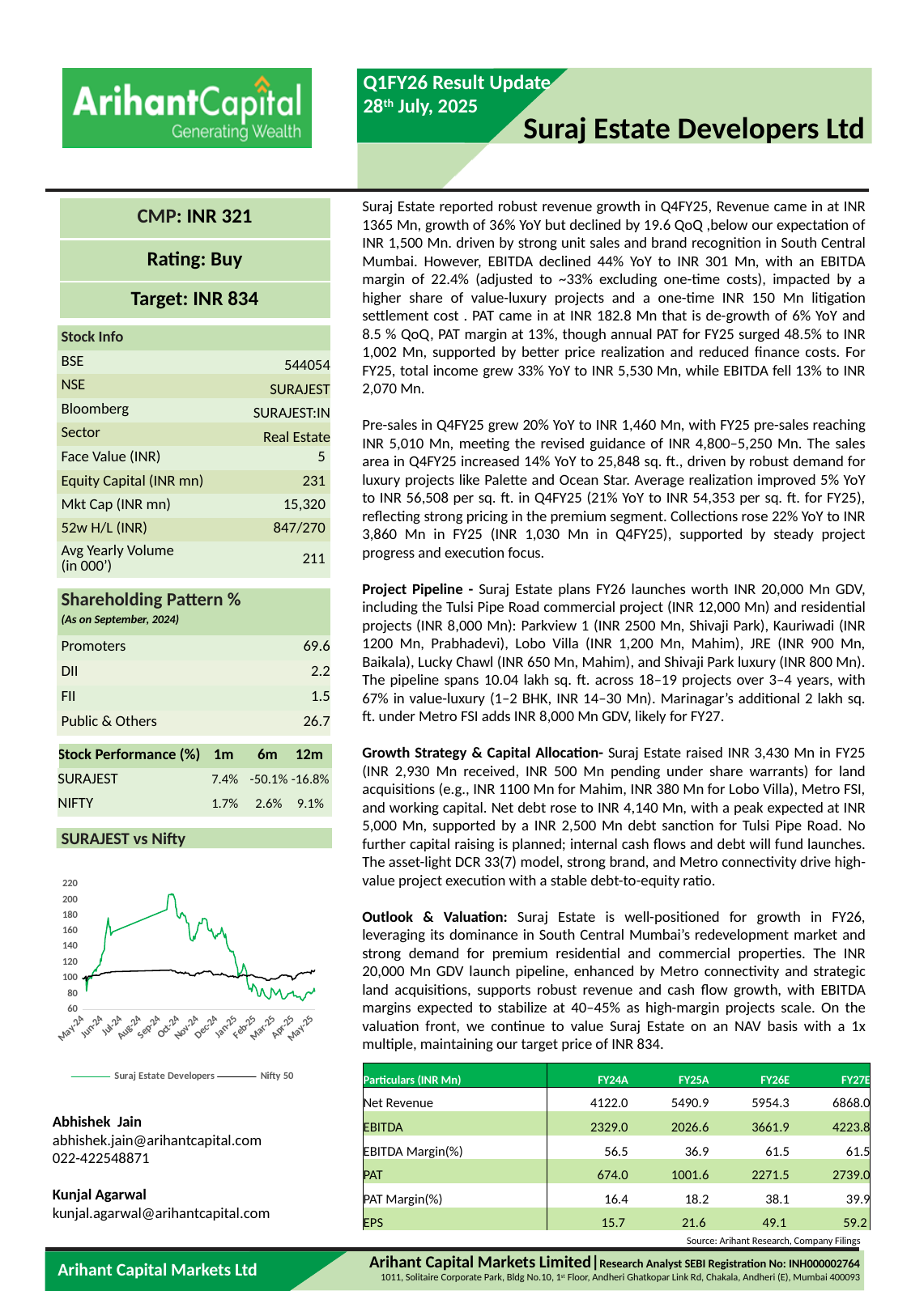
What is the title of the line chart on the slide? SURAJEST vs Nifty How many month labels are shown on the x axis of the 'SURAJEST vs Nifty' chart? 13 In the 'SURAJEST vs Nifty' chart, is the highest point of the Suraj Estate Developers line greater or less than 180? greater In the 'SURAJEST vs Nifty' chart, which series is higher at May-25, Suraj Estate Developers or Nifty 50? Nifty 50 What type of chart is the 'SURAJEST vs Nifty' chart? Line chart What are the two series named in the legend of the 'SURAJEST vs Nifty' chart? Suraj Estate Developers and Nifty 50 In the 'SURAJEST vs Nifty' chart, which series is higher at Oct-24, Suraj Estate Developers or Nifty 50? Suraj Estate Developers In the 'SURAJEST vs Nifty' chart, is the Suraj Estate Developers value at Mar-25 greater or less than 120? less In the 'SURAJEST vs Nifty' chart, does the Suraj Estate Developers line rise or fall from Oct-24 to May-25? Fall In the 'SURAJEST vs Nifty' chart, is the Nifty 50 value at Oct-24 greater or less than 140? less How many series does the legend of the 'SURAJEST vs Nifty' chart list? 2